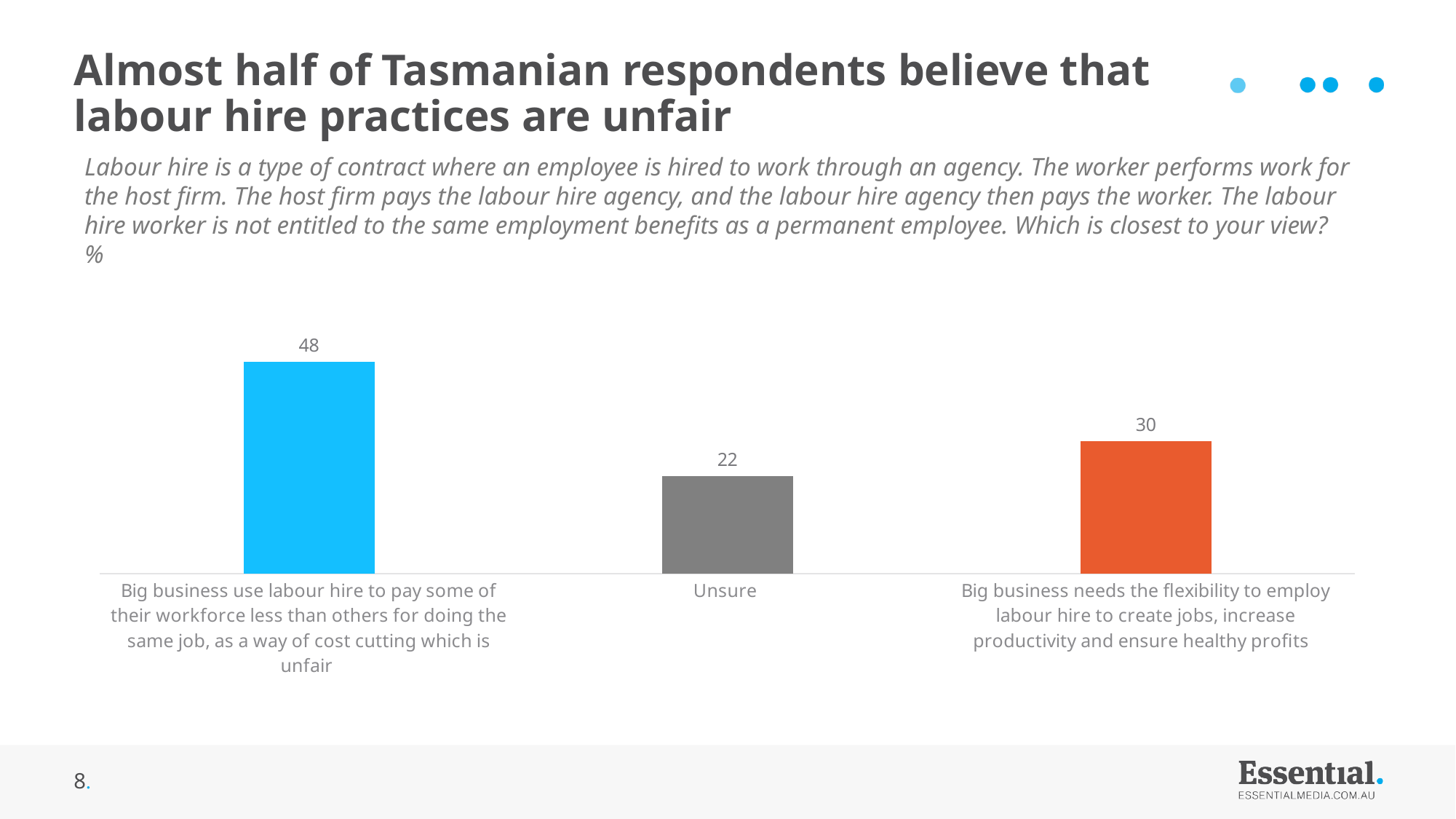
What is the difference between the 'flexibility' response and 'Unsure'? 8 What value is shown for 'Big business needs the flexibility to employ labour hire to create jobs, increase productivity and ensure healthy profits'? 30 Which is larger: the value for 'Unsure' or the value for the 'flexibility' response? Big business needs the flexibility to employ labour hire to create jobs, increase productivity and ensure healthy profits What is the total of the three values shown in the chart? 100 What colour is the bar for the 'Unsure' category? Grey What kind of chart is shown on the slide? Bar chart What is the difference between the value for the 'unfair' cost-cutting response (48) and the 'flexibility' response (30)? 18 Which category has the highest value? Big business use labour hire to pay some of their workforce less than others for doing the same job, as a way of cost cutting which is unfair What value is shown for 'Big business use labour hire to pay some of their workforce less than others for doing the same job, as a way of cost cutting which is unfair'? 48 What is the value for the 'Unsure' category? 22 Which category has the lowest value? Unsure How many categories are shown in the chart? 3